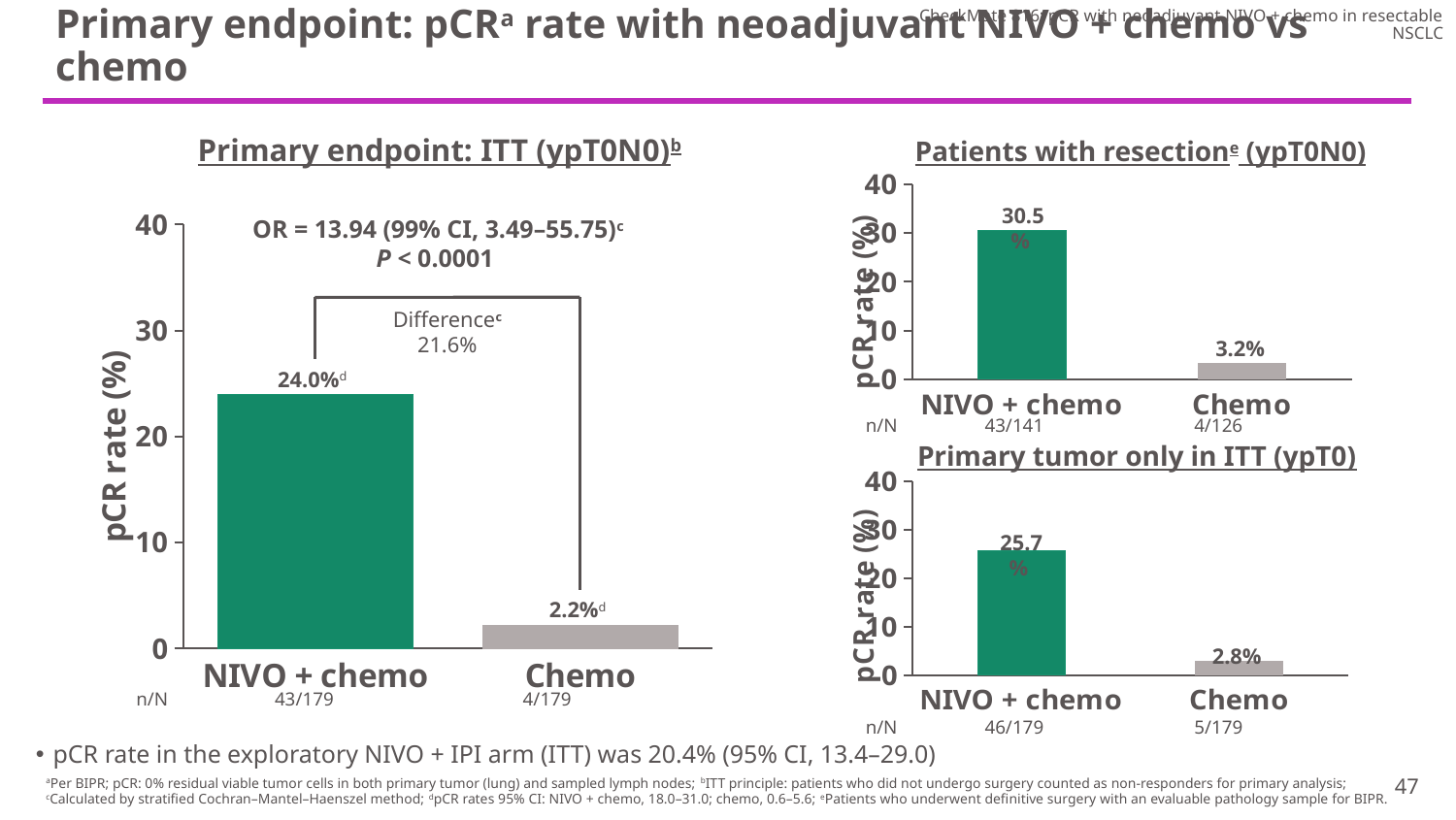
In the 'Primary tumor only in ITT (ypT0)' chart, what is the pCR rate for Chemo? 2.8% What kind of chart is the 'Primary endpoint: ITT (ypT0N0)' chart? Bar chart In the 'Primary endpoint: ITT (ypT0N0)' chart, what is the pCR rate for NIVO + chemo? 24.0% In the 'Patients with resection (ypT0N0)' chart, which arm has the lowest pCR rate? Chemo In the 'Patients with resection (ypT0N0)' chart, what is the pCR rate for NIVO + chemo? 30.5% How many categories are shown on the x axis of the 'Primary endpoint: ITT (ypT0N0)' chart? 2 In the 'Primary tumor only in ITT (ypT0)' chart, which arm has the higher pCR rate? NIVO + chemo In the 'Primary endpoint: ITT (ypT0N0)' chart, what is the pCR rate for Chemo? 2.2% In the 'Patients with resection (ypT0N0)' chart, what is the pCR rate for Chemo? 3.2% In the 'Primary tumor only in ITT (ypT0)' chart, what is the pCR rate for NIVO + chemo? 25.7% In the 'Primary endpoint: ITT (ypT0N0)' chart, is the pCR rate for NIVO + chemo greater or less than 20? greater